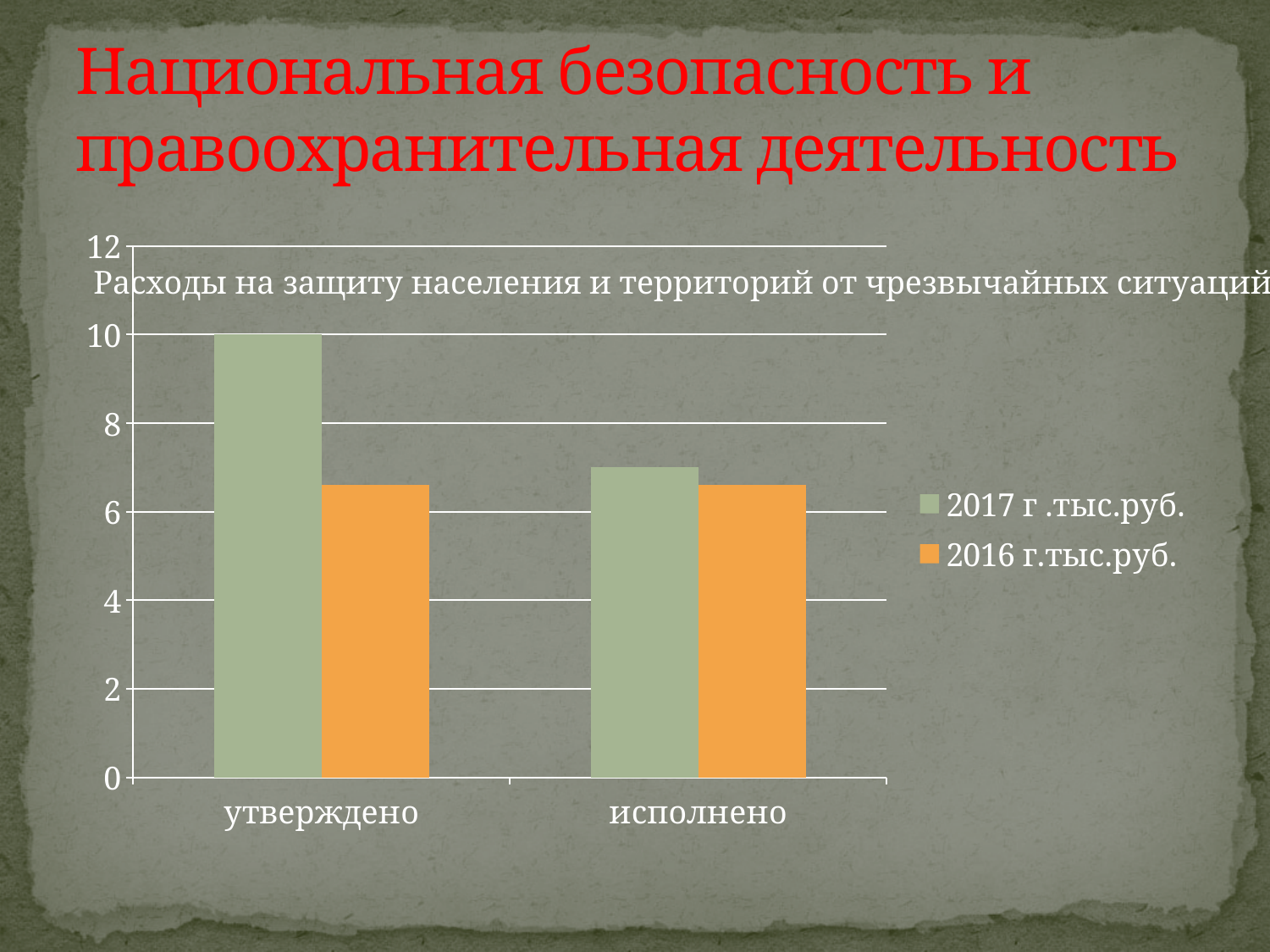
Which bar is the highest in the chart? 2017 г .тыс.руб., утверждено Does the 2017 г .тыс.руб. series rise or fall from утверждено to исполнено? fall What is the value for 2017 г .тыс.руб. in the category утверждено? 10 What is the title of the chart? Расходы на защиту населения и территорий от чрезвычайных ситуаций Is the value for 2016 г.тыс.руб. in the category утверждено greater or less than 6? greater Is the value for 2017 г .тыс.руб. in the category исполнено greater or less than 8? less What kind of chart is shown on the slide? bar chart Is the value for 2016 г.тыс.руб. in the category исполнено greater or less than 8? less Which colour represents the 2016 г.тыс.руб. series? orange In the category утверждено, which is larger: 2017 г .тыс.руб. or 2016 г.тыс.руб.? 2017 г .тыс.руб. How many series does the legend list? 2 How many categories are shown on the x axis? 2